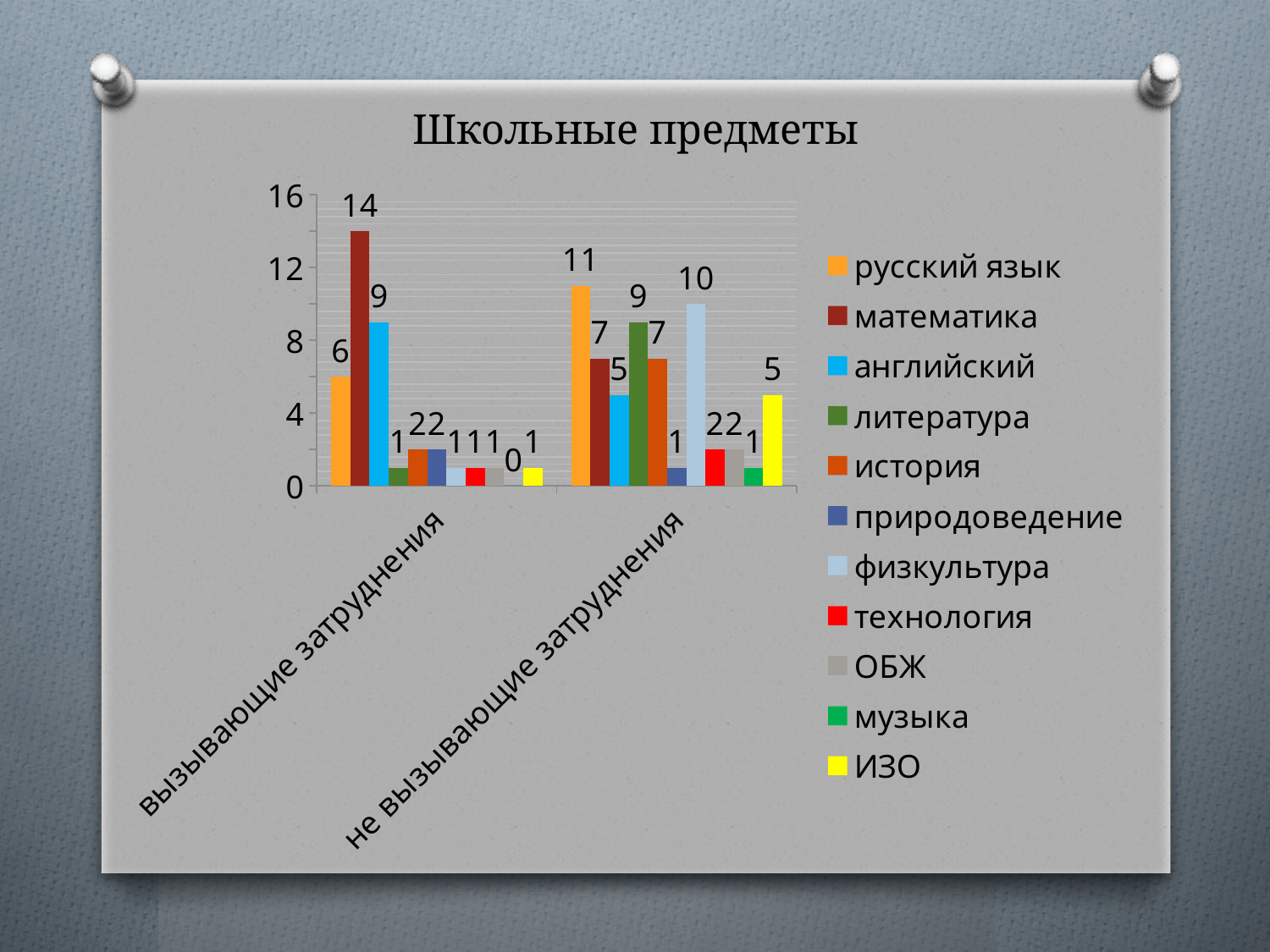
What is the value for ИЗО in the category не вызывающие затруднения? 5 What type of chart is shown on the slide? bar chart What is the difference between the values for математика and английский in the category вызывающие затруднения? 5 Which is larger in the category не вызывающие затруднения: литература or история? литература Which subject has the highest value in the category вызывающие затруднения? математика What is the value for русский язык in the category не вызывающие затруднения? 11 What is the value for математика in the category вызывающие затруднения? 14 How many categories are shown on the x axis? 2 How many series does the legend list? 11 What is the value for физкультура in the category не вызывающие затруднения? 10 What is the title of the chart? Школьные предметы Which subject has the lowest value in the category вызывающие затруднения? музыка